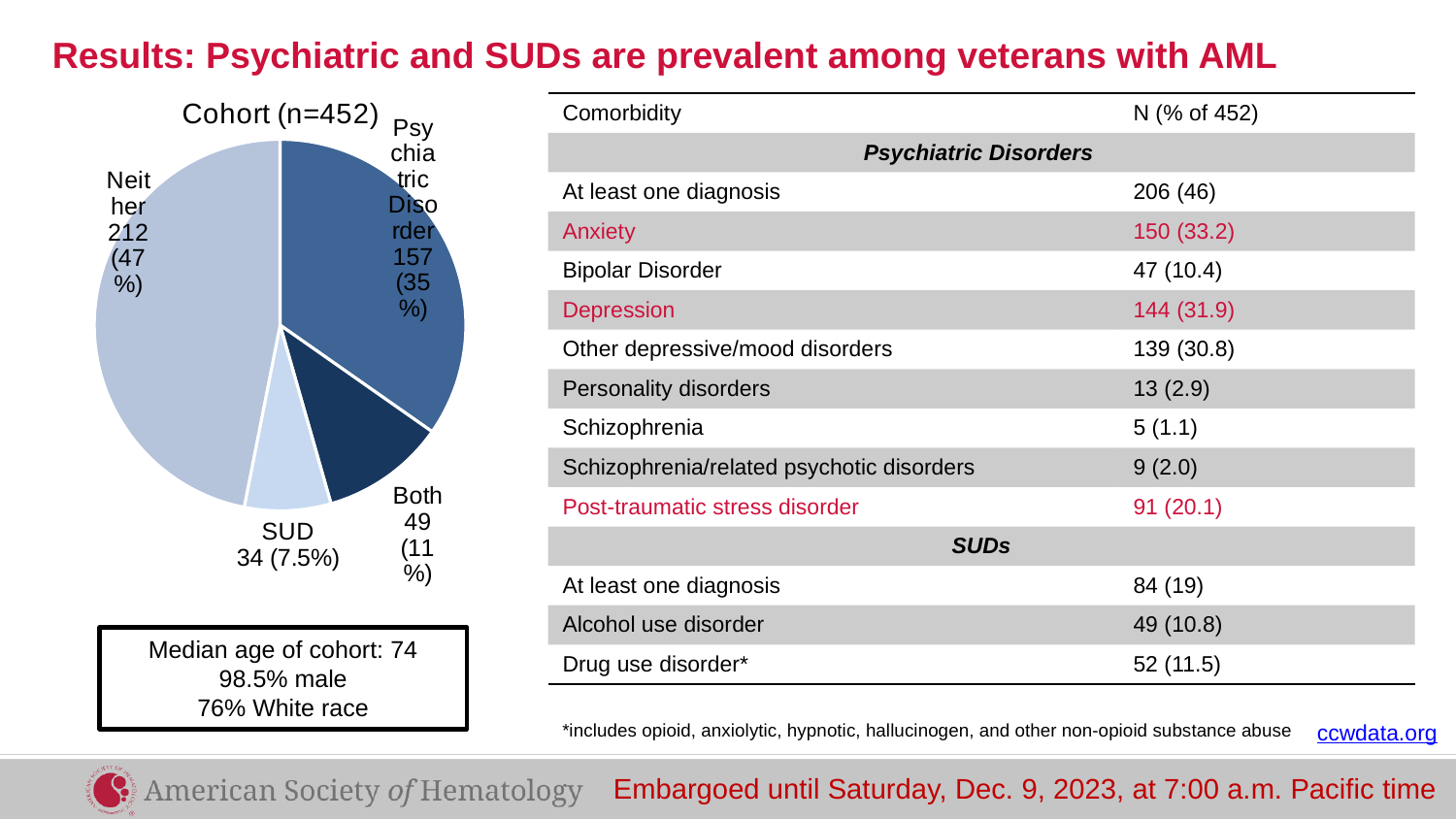
How many slices does the pie chart have? 4 What kind of chart is shown on the left of the slide? pie chart In the pie chart, how many veterans are in the 'SUD' group? 34 Which slice of the pie chart is the smallest? SUD What share of the pie chart does the 'Psychiatric Disorder' slice represent? 35% Which slice of the pie chart is the largest? Neither In the pie chart, how many veterans are in the 'Both' group? 49 What share of the pie chart does the 'SUD' slice represent? 7.5% In the pie chart, how many more veterans are in the 'Neither' group than in the 'Psychiatric Disorder' group? 55 In the pie chart, how many veterans are in the 'Neither' group? 212 What is the title of the pie chart? Cohort (n=452) In the pie chart, how many veterans are in the 'Psychiatric Disorder' group? 157